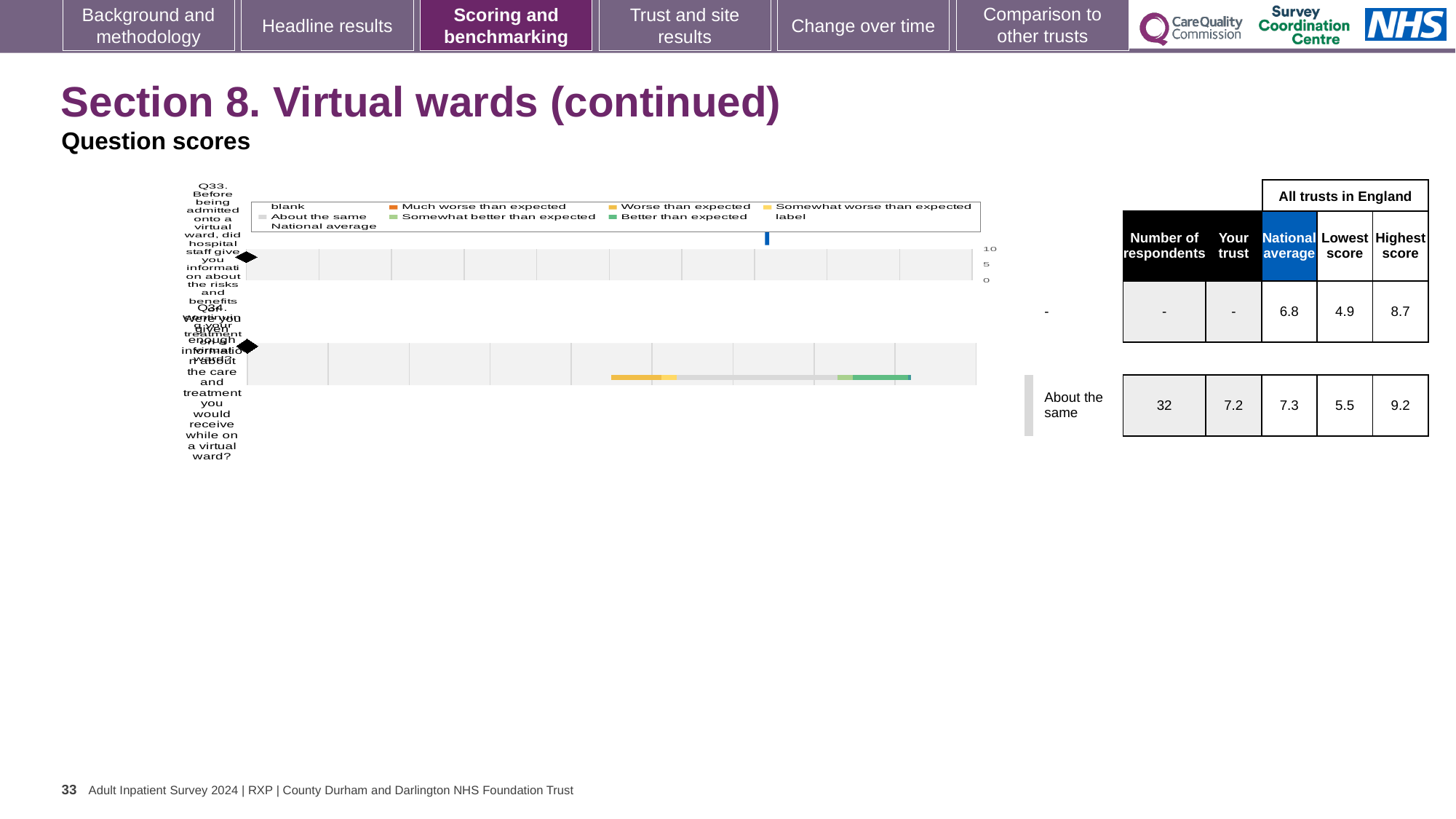
What kind of chart is shown on the slide? bar chart What is the highest score across all trusts in England for Q34? 9.2 What is the national average for Q33 in the table next to the chart? 6.8 What is the national average for Q34 in the table next to the chart? 7.3 What is the number of respondents for Q34 in the table next to the chart? 32 Which is larger for Q34: the 'Your trust' score or the national average? national average What is the 'Your trust' score for Q34 in the table next to the chart? 7.2 What is the highest value shown on the chart's axis? 10 What is the difference between the highest and lowest scores for Q34 across all trusts in England? 3.7 How many questions (categories) are plotted on the chart? 2 What is the lowest score across all trusts in England for Q33? 4.9